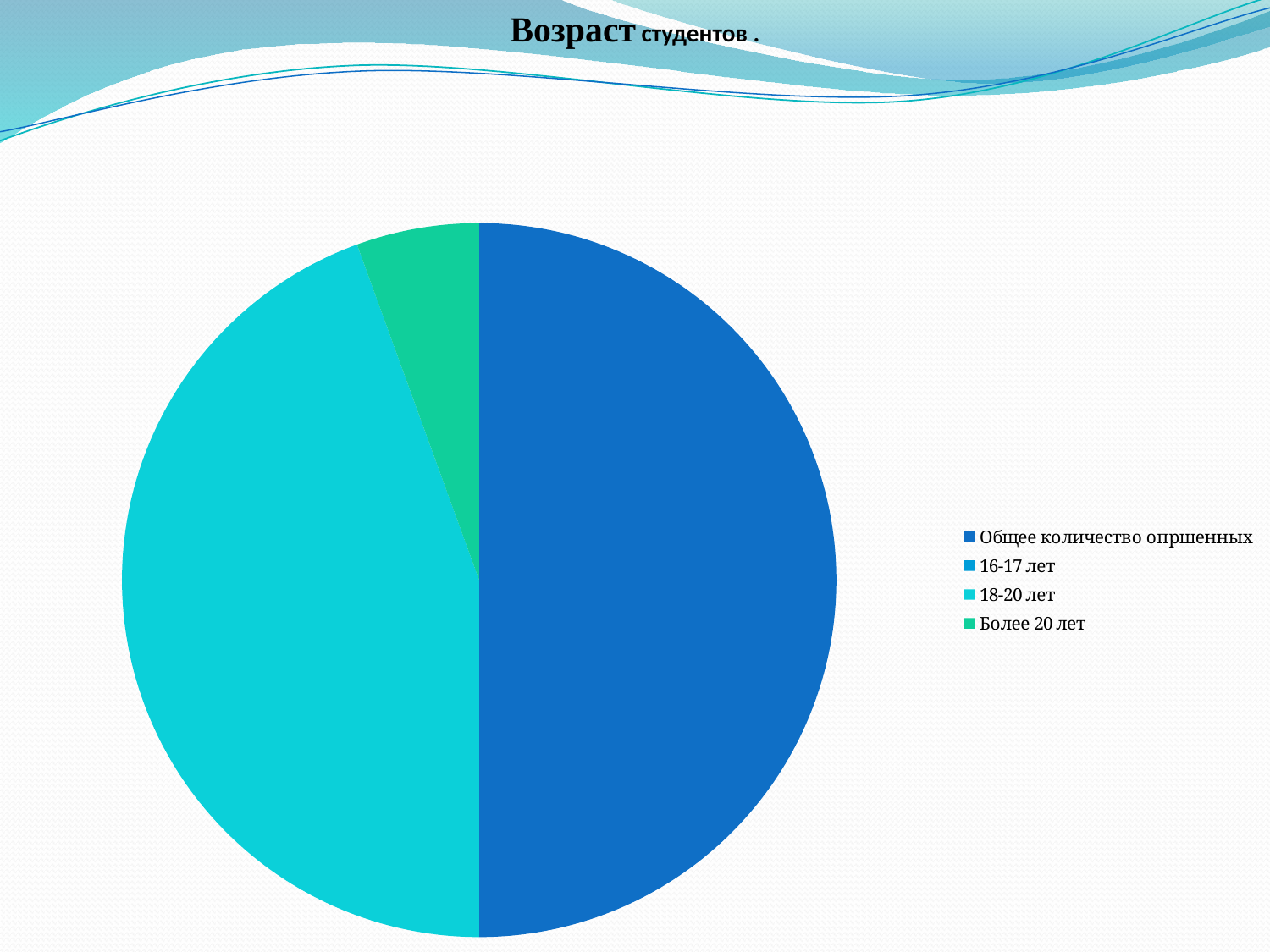
Which slice is larger, "18-20 лет" or "Более 20 лет"? 18-20 лет What is the last entry listed in the legend of the pie chart? Более 20 лет Which legend category has the largest slice in the pie chart? Общее количество опршенных Which slice is larger, "Общее количество опршенных" or "Более 20 лет"? Общее количество опршенных Which slice is larger, "Общее количество опршенных" or "18-20 лет"? Общее количество опршенных What is the title of the slide with the pie chart? Возраст студентов How many entries does the legend of the pie chart list? 4 What kind of chart is shown on the slide? pie chart